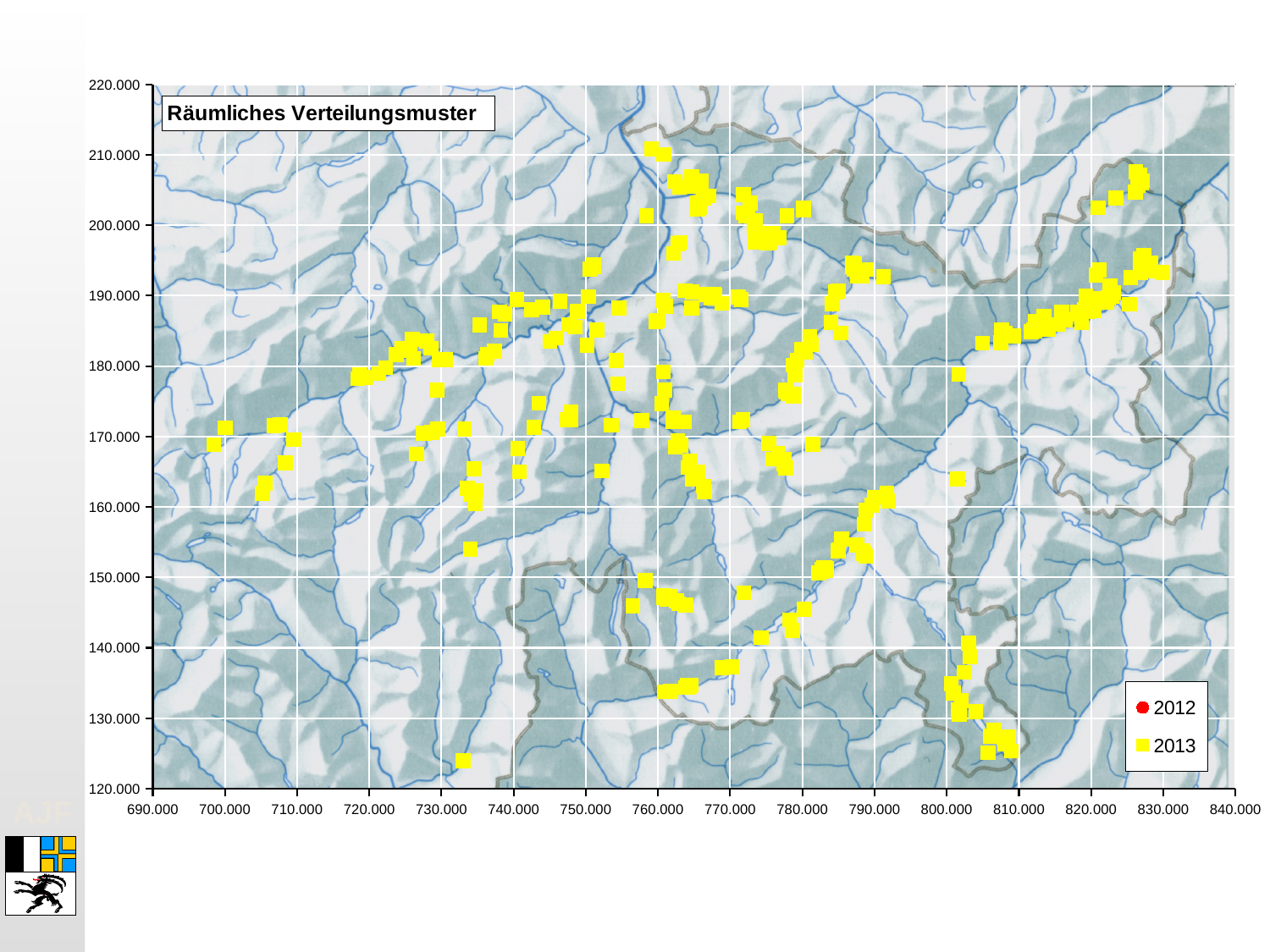
Is the rightmost plotted point on the chart at an x value greater or less than 840.000? less What is the title of the chart? Räumliches Verteilungsmuster How many series does the legend list? 2 What kind of chart is shown on the slide? scatter chart Which colour marks the 2013 series in the legend? yellow Is the lowest plotted point on the chart above or below 130.000 on the y axis? below